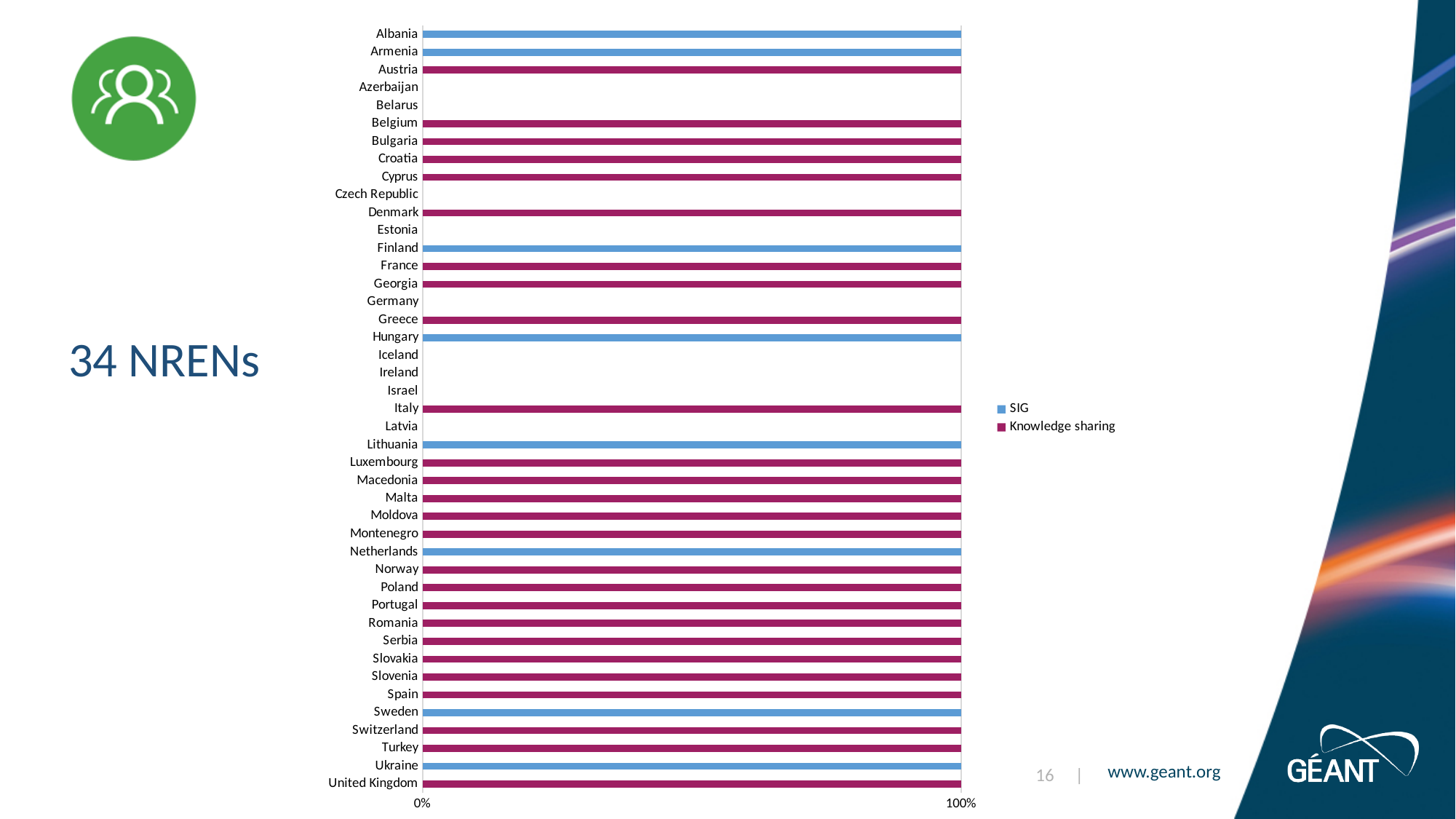
What value does the bar for Austria reach? 100% What are the two series named in the legend? SIG and Knowledge sharing Which series does the bar for Hungary belong to? SIG How many series does the legend list? 2 Which series is shown in blue? SIG Which series does the bar for Italy belong to? Knowledge sharing How many countries have a SIG (blue) bar? 8 How many countries have no bar at all? 9 What value does the SIG bar for Finland reach? 100% How many countries are listed on the vertical axis of the chart? 43 What kind of chart is shown on the slide? bar chart